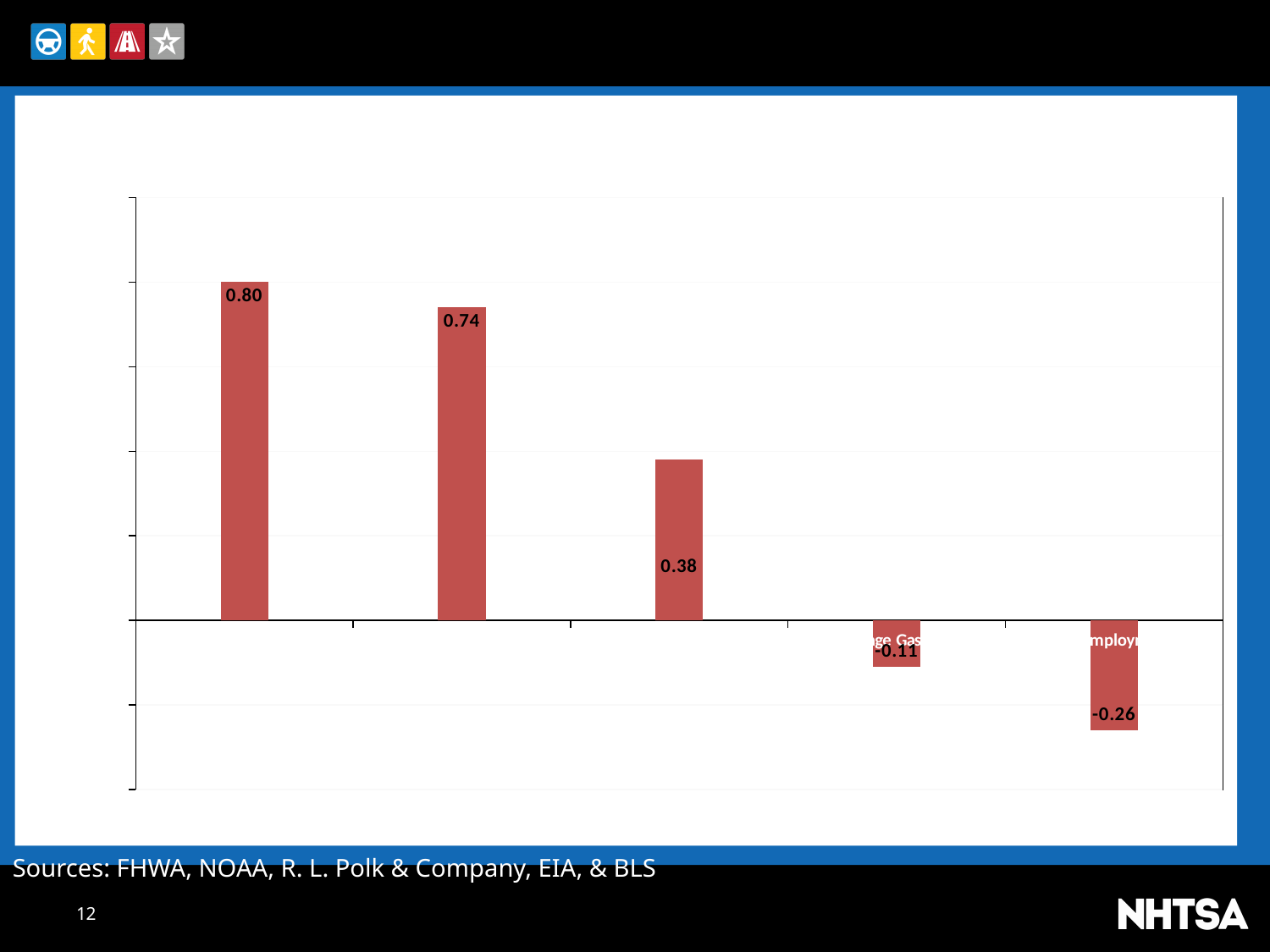
Which is larger, the value of the second bar from the left or the value of the third bar? the second bar (0.74) Do the bar values rise or fall moving from left to right across the chart? fall What is the value labelled on the second bar from the left? 0.74 What is the value labelled on the rightmost bar? -0.26 Which bar has the highest value? the leftmost bar (0.80) What kind of chart is shown on the slide? bar chart How many bars are plotted in the chart? 5 What is the difference between the leftmost bar's value and the middle bar's value? 0.42 What is the value labelled on the middle (third) bar? 0.38 What is the value labelled on the leftmost bar? 0.80 What is the value labelled on the fourth bar from the left? -0.11 Which bar has the lowest value? the rightmost bar (-0.26)